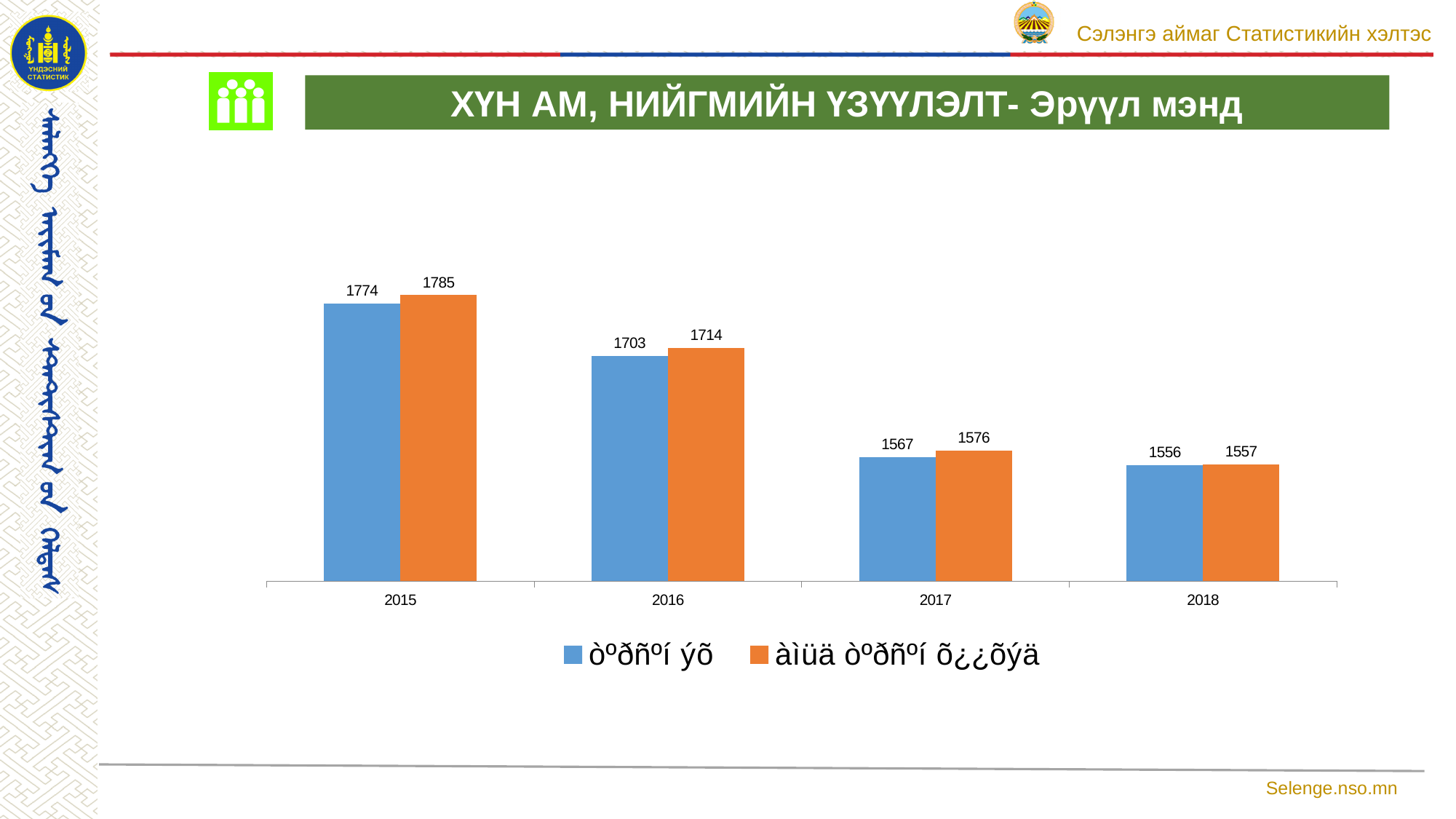
What is the value of the blue bar for 2017? 1567 What kind of chart is shown on the slide? bar chart What is the value of the blue bar for 2015? 1774 How many series does the legend list? 2 How many years are shown on the x axis? 4 What is the value of the orange bar for 2018? 1557 What is the difference between the blue bar values for 2015 and 2016? 71 In which year is the orange series lowest? 2018 What is the difference between the orange and blue bar values for 2017? 9 What is the value of the orange bar for 2016? 1714 Which is larger, the blue bar for 2016 or the blue bar for 2017? 2016 In which year is the blue series highest? 2015